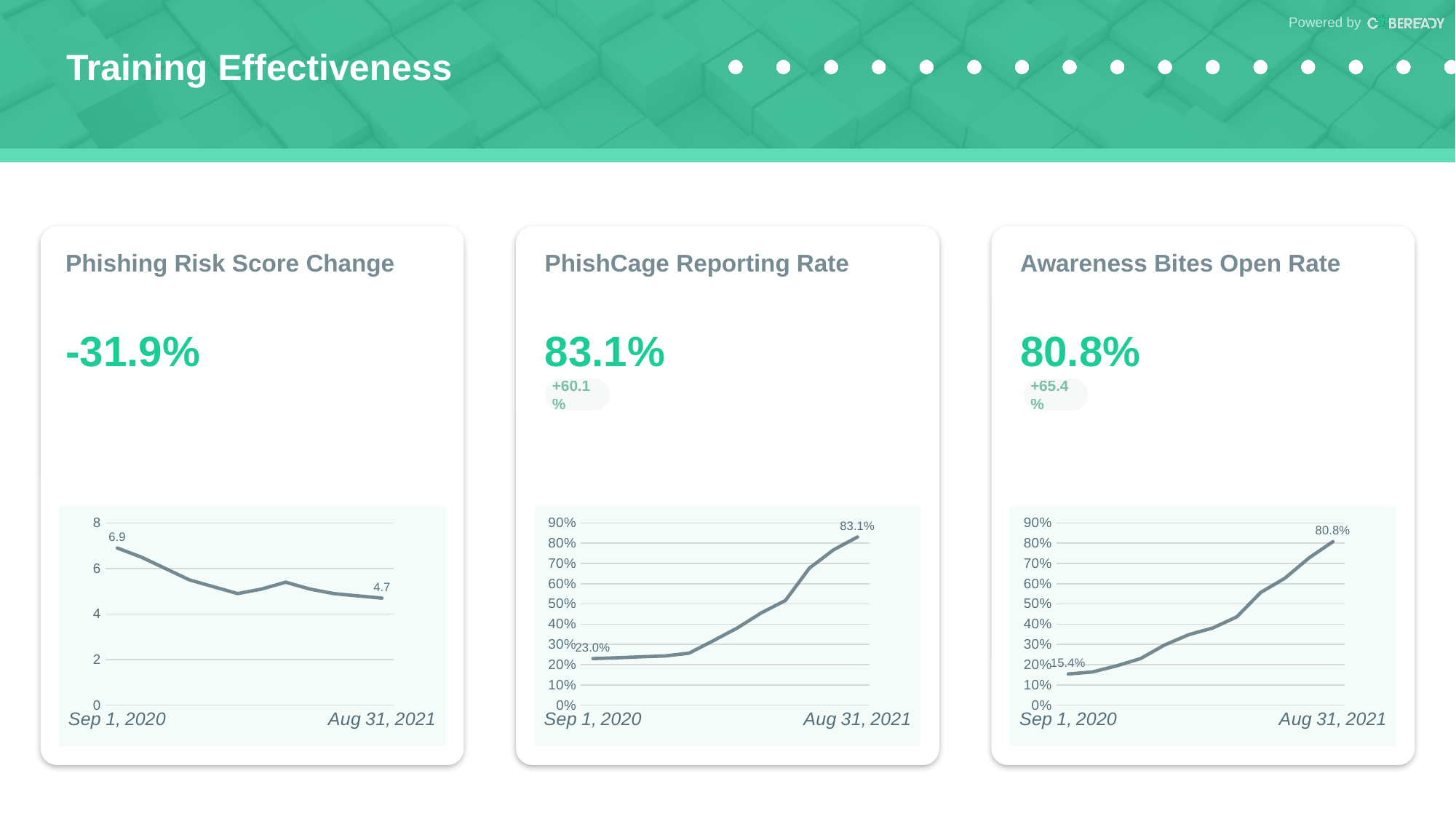
On the Awareness Bites Open Rate chart, what is the value on Sep 1, 2020? 15.4% What kind of chart is the Awareness Bites Open Rate chart? line chart On the PhishCage Reporting Rate chart, what is the value on Aug 31, 2021? 83.1% On the Awareness Bites Open Rate chart, what is the value on Aug 31, 2021? 80.8% On the PhishCage Reporting Rate chart, what is the value on Sep 1, 2020? 23.0% On the Phishing Risk Score Change chart, by how much did the value fall from Sep 1, 2020 to Aug 31, 2021? 2.2 On the Phishing Risk Score Change chart, what is the value on Aug 31, 2021? 4.7 On the Awareness Bites Open Rate chart, does the line rise or fall from Sep 1, 2020 to Aug 31, 2021? rise Which is larger: the Aug 31, 2021 value on the PhishCage Reporting Rate chart or the Aug 31, 2021 value on the Awareness Bites Open Rate chart? PhishCage Reporting Rate On the PhishCage Reporting Rate chart, what is the difference between the Aug 31, 2021 value and the Sep 1, 2020 value? 60.1% On the Phishing Risk Score Change chart, what is the value on Sep 1, 2020? 6.9 On the Phishing Risk Score Change chart, does the line rise or fall overall from Sep 1, 2020 to Aug 31, 2021? fall